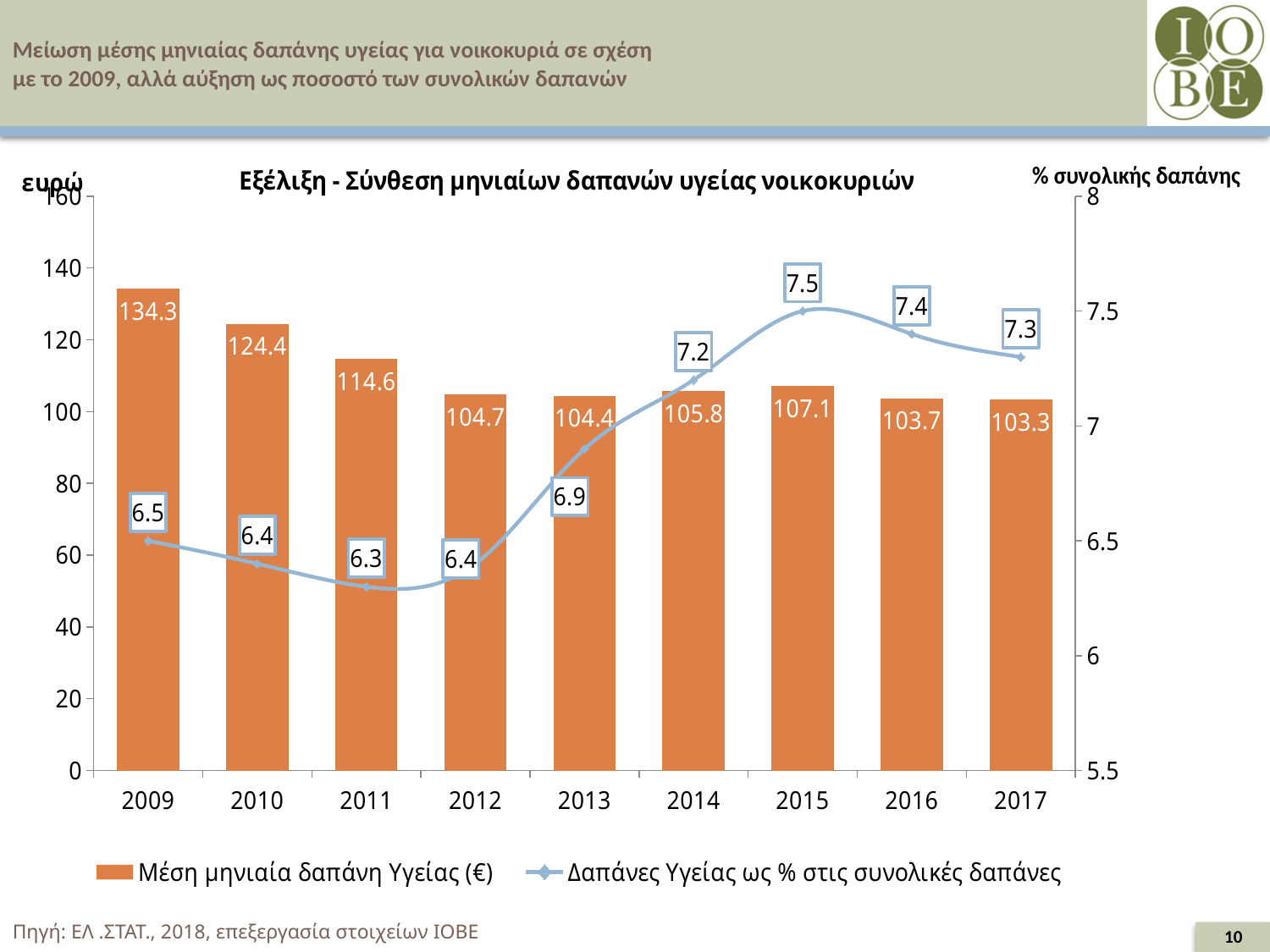
Which year has a higher average monthly health expenditure, 2014 or 2015? 2015 Is the average monthly health expenditure in 2011 greater or less than 100? greater What is the value of health expenditure as % of total expenditure (Δαπάνες Υγείας ως % στις συνολικές δαπάνες) in 2015? 7.5 What is the title of the chart? Εξέλιξη - Σύνθεση μηνιαίων δαπανών υγείας νοικοκυριών In which year is the average monthly health expenditure (bars) highest? 2009 What is the average monthly health expenditure (Μέση μηνιαία δαπάνη Υγείας) in 2009? 134.3 Does the average monthly health expenditure (bars) rise or fall from 2009 to 2012? fall What is the average monthly health expenditure in 2017? 103.3 How many series does the legend list? 2 What is the difference between the average monthly health expenditure in 2009 and in 2017? 31 In which year is the health expenditure as % of total expenditure (line) lowest? 2011 How many years are shown on the x axis of the chart? 9